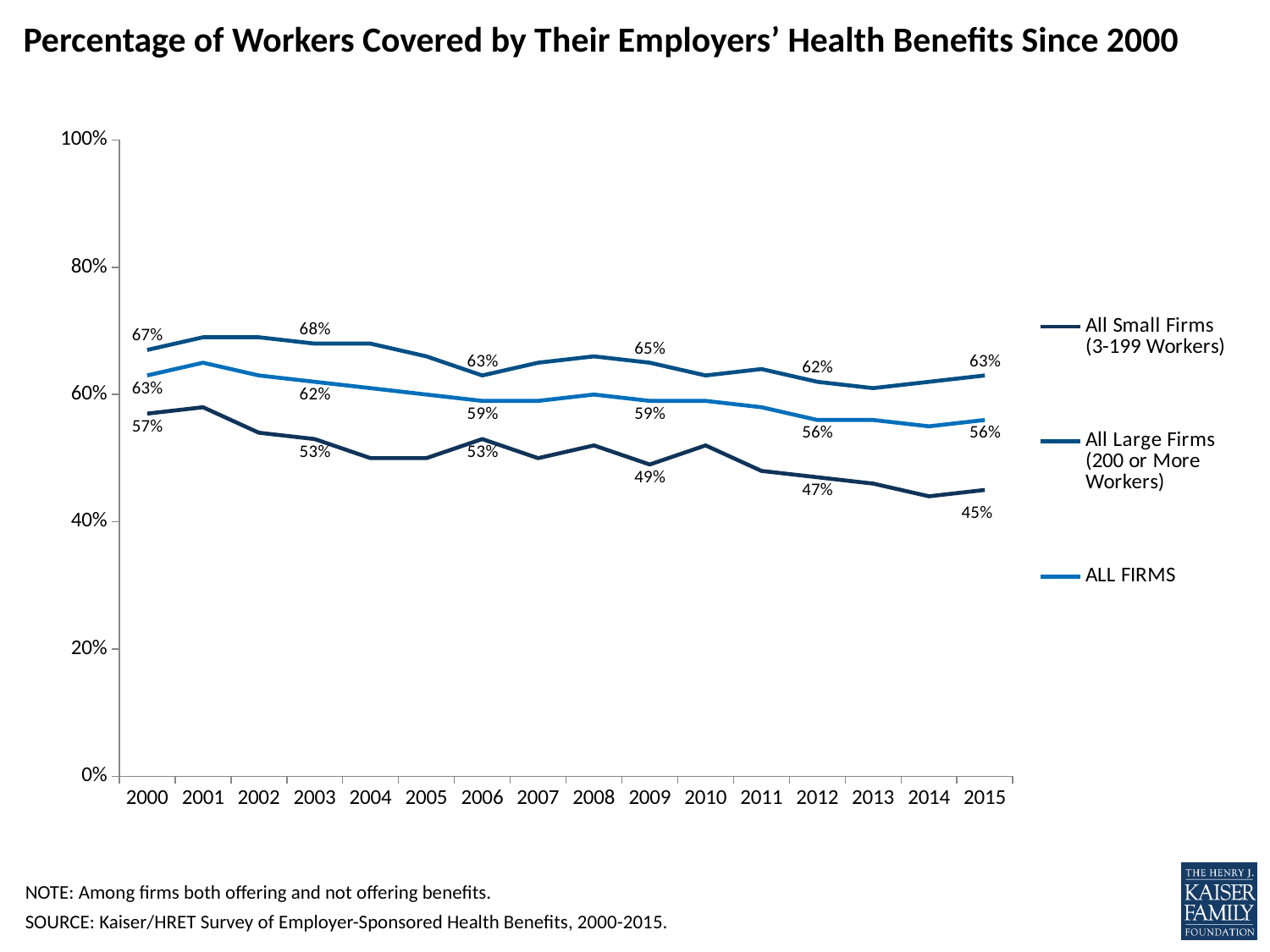
By how much did the ALL FIRMS value fall from 2000 to 2015? 7% What was the value for ALL FIRMS in 2012? 56% What kind of chart is shown on the slide? Line chart Which series had the higher value in 2009, All Large Firms or ALL FIRMS? All Large Firms What percentage of workers at All Small Firms (3-199 Workers) were covered in 2015? 45% How many series does the legend list? 3 What was the value for All Small Firms (3-199 Workers) in 2000? 57% What was the value for All Large Firms (200 or More Workers) in 2003? 68% Does the All Small Firms line generally rise or fall from 2000 to 2015? Fall Is the value for All Small Firms in 2004 greater or less than 60%? less What is the difference between the All Large Firms value and the All Small Firms value in 2015? 18% Is the value for All Large Firms in 2001 greater or less than 60%? greater